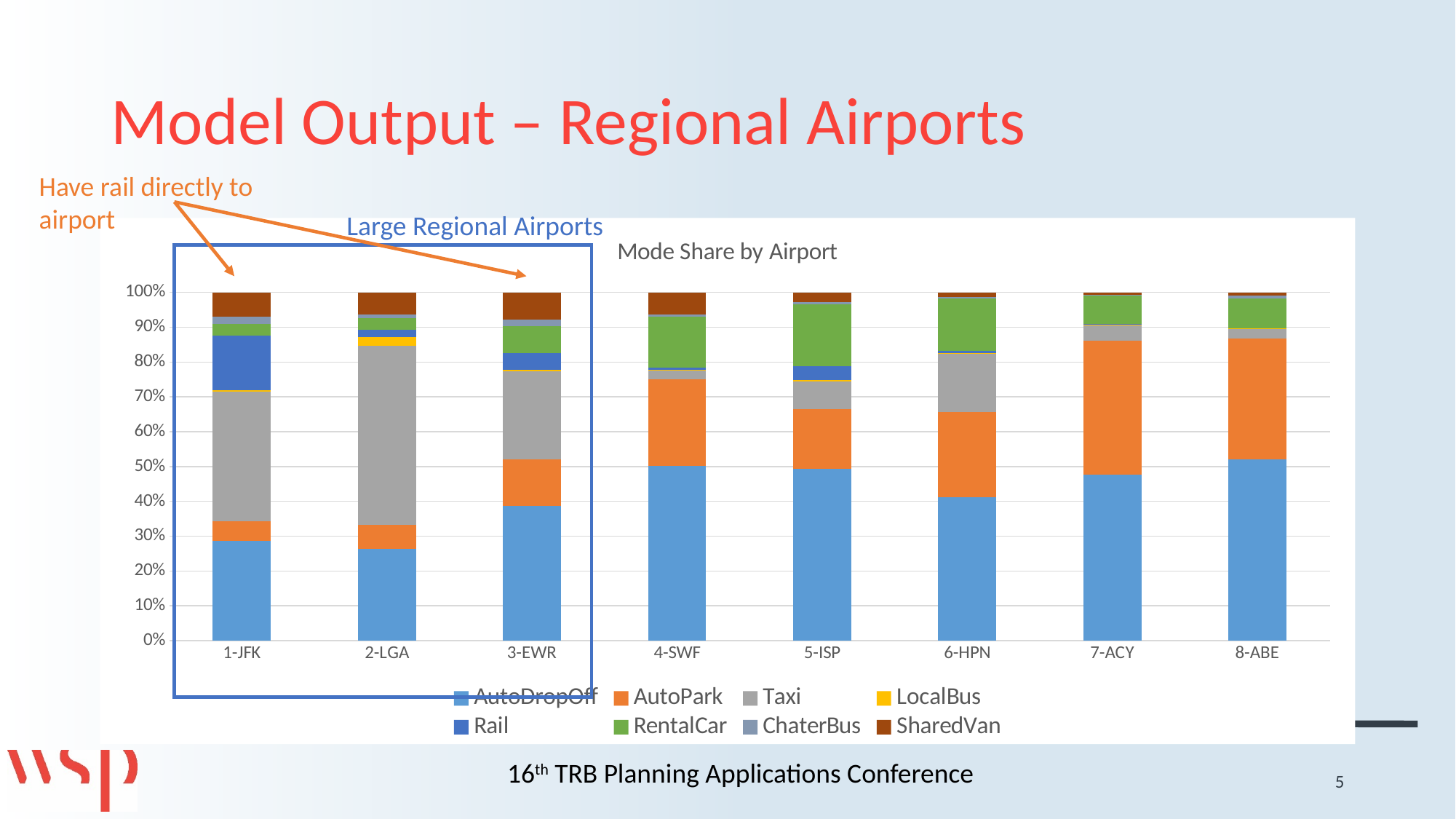
What kind of chart is shown on the slide? Stacked bar chart What is the title of the chart? Mode Share by Airport Which airport has a larger Taxi share, 2-LGA or 8-ABE? 2-LGA Is the AutoDropOff share for 4-SWF greater or less than 40%? greater Which airports are enclosed in the box labelled 'Large Regional Airports'? 1-JFK, 2-LGA, 3-EWR Is the AutoDropOff share for 2-LGA greater or less than 30%? less How many series does the chart legend list? 8 Which airport has a larger AutoPark share, 7-ACY or 1-JFK? 7-ACY How many airports are shown on the x axis of the chart? 8 What is the total of the stacked bar for 1-JFK? 100% Which airport has a larger AutoDropOff share, 1-JFK or 3-EWR? 3-EWR Is the AutoDropOff share for 8-ABE greater or less than 50%? greater